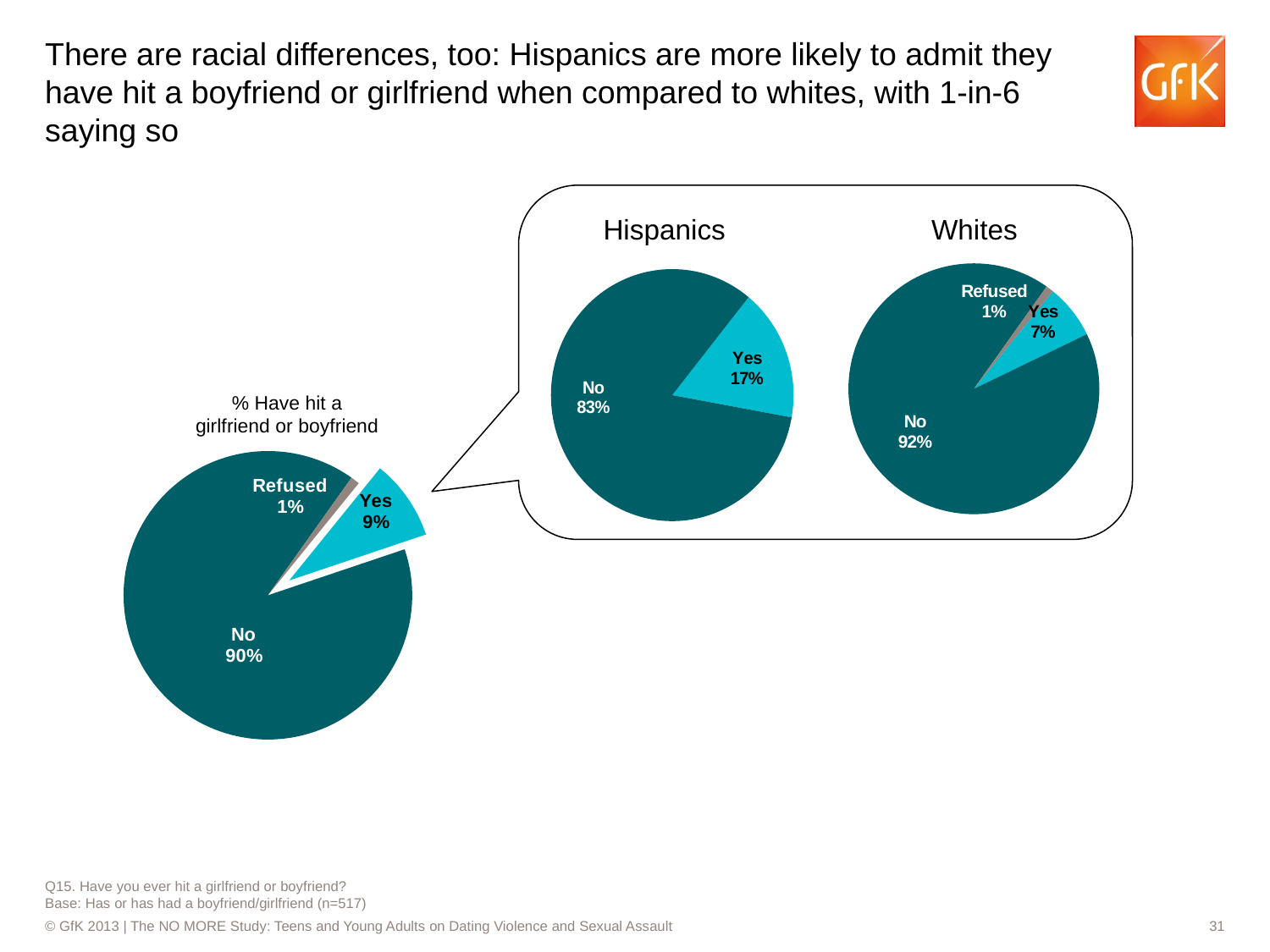
In the Whites pie chart, what percentage answered No? 92% In the Whites pie chart, what percentage answered Yes? 7% In the '% Have hit a girlfriend or boyfriend' pie chart, what percentage answered Yes? 9% In the '% Have hit a girlfriend or boyfriend' pie chart, what percentage Refused? 1% In the '% Have hit a girlfriend or boyfriend' pie chart, what percentage answered No? 90% In the Hispanics pie chart, what percentage answered No? 83% What kind of chart is used to show the Whites data? Pie chart In the Hispanics pie chart, what percentage answered Yes? 17% Which pie chart has the larger Yes share, Hispanics or Whites? Hispanics What is the difference between the Yes percentage for Hispanics and the Yes percentage for Whites? 10% In the '% Have hit a girlfriend or boyfriend' pie chart, which category has the smallest slice? Refused How many slices does the Hispanics pie chart have? 2